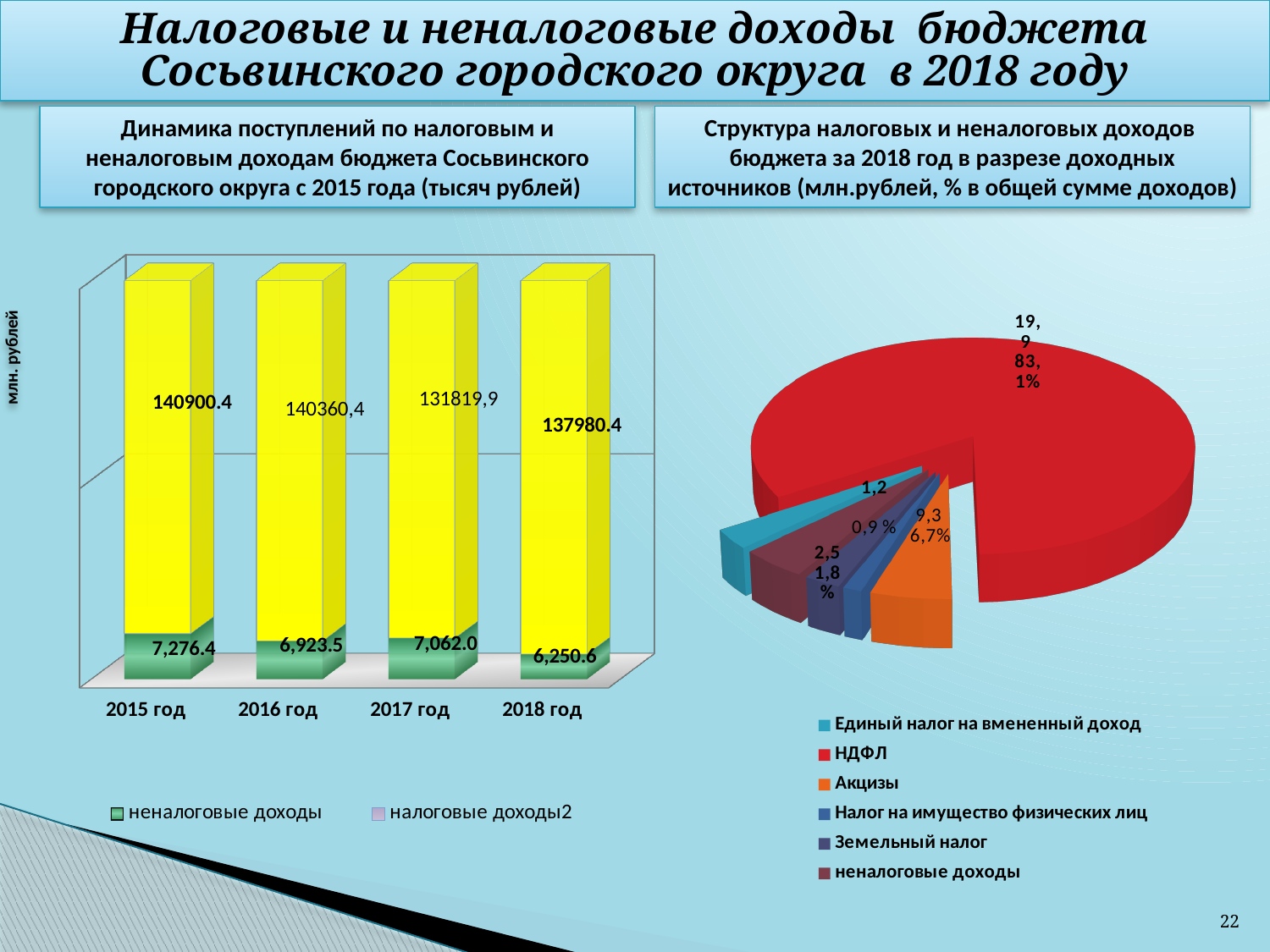
In the left bar chart, what is the value of налоговые доходы2 for 2017 год? 131819,9 How many years are shown on the x axis of the left bar chart? 4 In the left bar chart, which year has the highest value for налоговые доходы2? 2015 год In the left bar chart, what is the difference between the неналоговые доходы values for 2015 год and 2018 год? 1,025.8 In the right pie chart, what share of total income does НДФЛ account for? 83,1% In the left bar chart, what is the value of неналоговые доходы for 2018 год? 6,250.6 In the left bar chart, is the value of неналоговые доходы larger in 2016 год or in 2017 год? 2017 год In the left bar chart, what is the value of налоговые доходы2 for 2015 год? 140900.4 In the left bar chart, which year has the lowest value for налоговые доходы2? 2017 год In the left bar chart, which year has the lowest value for неналоговые доходы? 2018 год How many entries does the legend of the right pie chart list? 6 How many series does the legend of the left chart list? 2